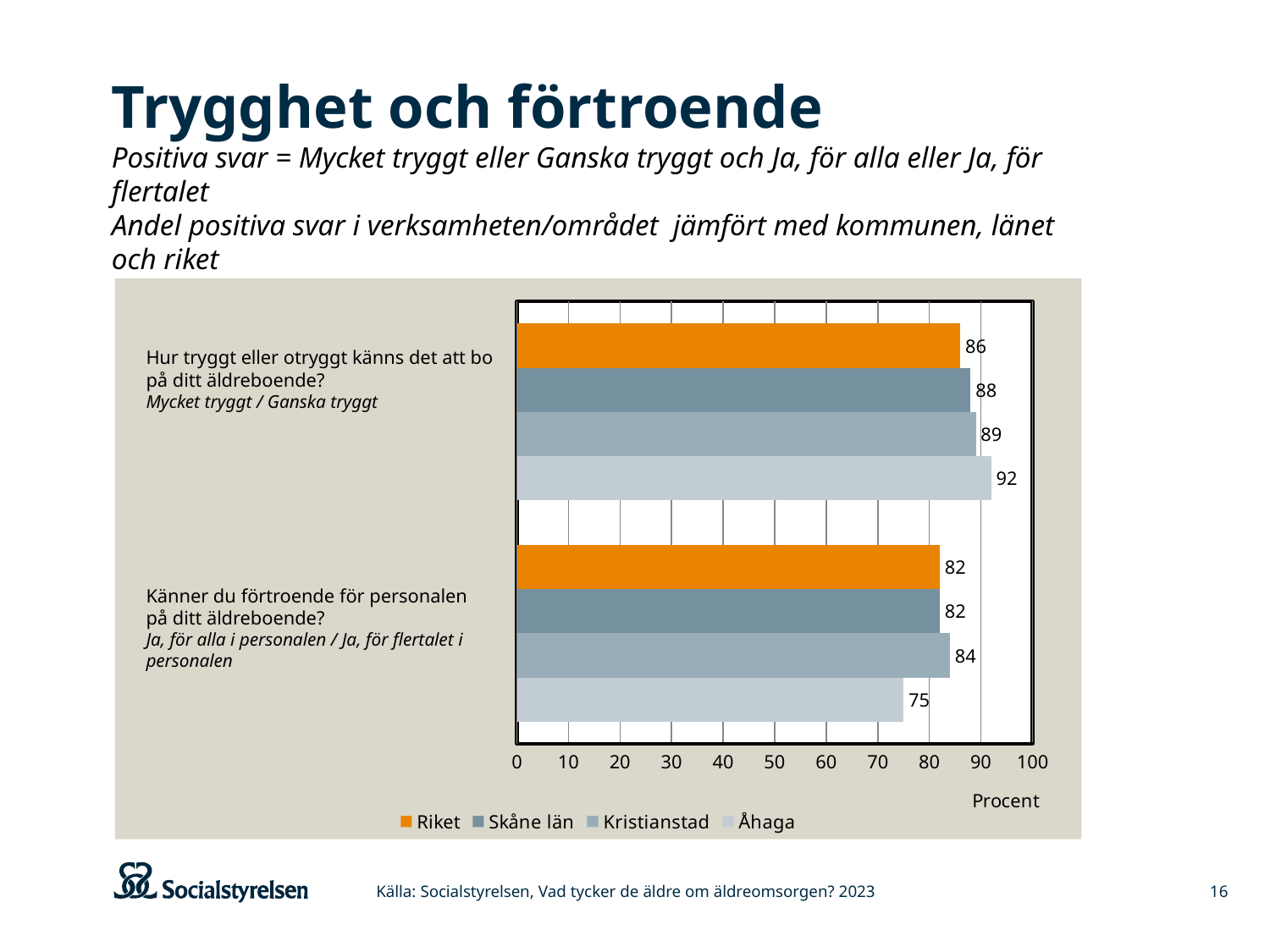
What is the value for Kristianstad on the question "Hur tryggt eller otryggt känns det att bo på ditt äldreboende?"? 89 What kind of chart is shown on the slide? Bar chart What is the value for Åhaga on the question "Känner du förtroende för personalen på ditt äldreboende?"? 75 Which series has the lowest value on the question "Känner du förtroende för personalen på ditt äldreboende?"? Åhaga What is the difference between Åhaga and Riket on the question "Hur tryggt eller otryggt känns det att bo på ditt äldreboende?"? 6 What is the value for Åhaga on the question "Hur tryggt eller otryggt känns det att bo på ditt äldreboende?"? 92 What is the label of the x axis? Procent Which is larger: Skåne län on the trygghet question or Skåne län on the förtroende question? Skåne län on the trygghet question How many series does the legend list? 4 Which series has the highest value on the question "Hur tryggt eller otryggt känns det att bo på ditt äldreboende?"? Åhaga What is the value for Riket on the question "Känner du förtroende för personalen på ditt äldreboende?"? 82 What is the difference between Kristianstad and Åhaga on the question "Känner du förtroende för personalen på ditt äldreboende?"? 9